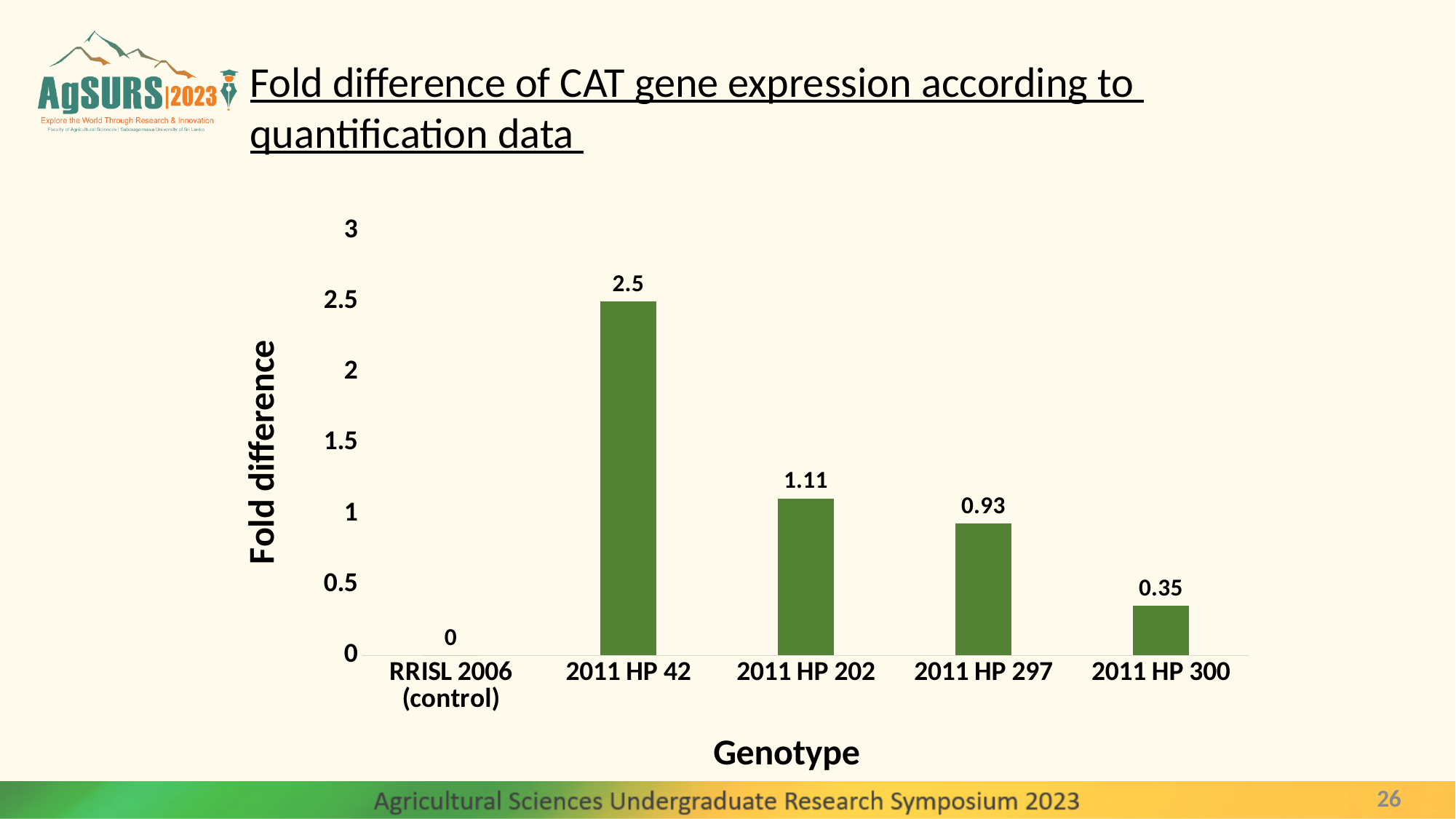
What is the fold difference for 2011 HP 202? 1.11 What is the fold difference for RRISL 2006 (control)? 0 How many genotypes are shown on the x axis? 5 What is the label of the y axis? Fold difference Which has a larger fold difference, 2011 HP 297 or 2011 HP 300? 2011 HP 297 What kind of chart is shown on the slide? Bar chart What is the fold difference for 2011 HP 42? 2.5 Which genotype has the lowest fold difference? RRISL 2006 (control) What is the difference in fold difference between 2011 HP 42 and 2011 HP 202? 1.39 Which genotype has the highest fold difference? 2011 HP 42 What is the fold difference for 2011 HP 297? 0.93 What is the fold difference for 2011 HP 300? 0.35